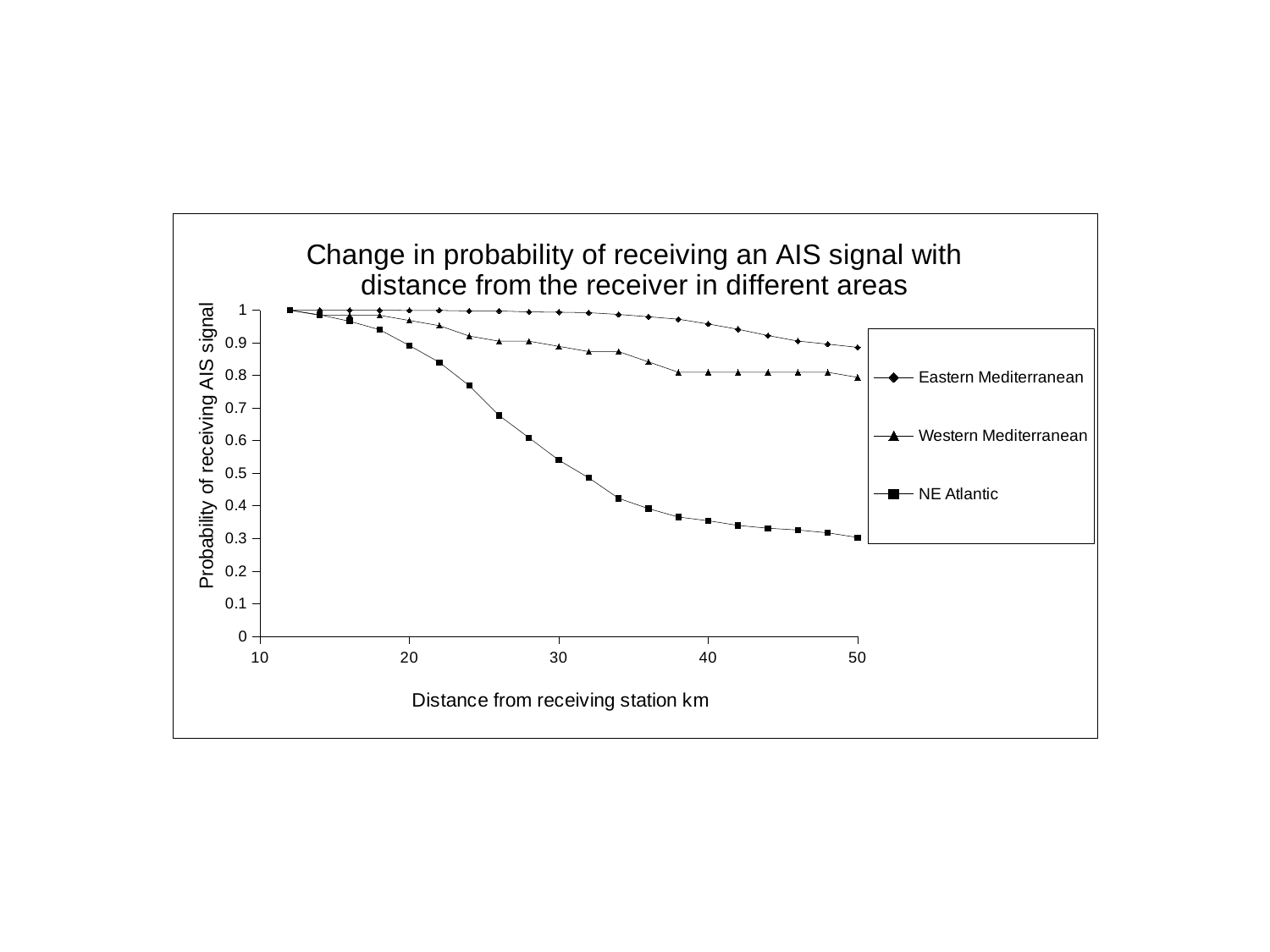
Which series has the lowest probability at 30 km? NE Atlantic What is the title of the chart? Change in probability of receiving an AIS signal with distance from the receiver in different areas Is the probability for NE Atlantic at 40 km greater or less than 0.4? less What kind of chart is shown on the slide? line chart Is the probability for Western Mediterranean at 30 km greater or less than 0.8? greater Does the probability for NE Atlantic rise or fall as distance increases? fall At 40 km, which is larger: the probability for Western Mediterranean or for NE Atlantic? Western Mediterranean Is the probability for NE Atlantic at 30 km greater or less than 0.5? greater How many series does the legend list? 3 What is the label of the x axis? Distance from receiving station km Which series has the highest probability at 50 km? Eastern Mediterranean